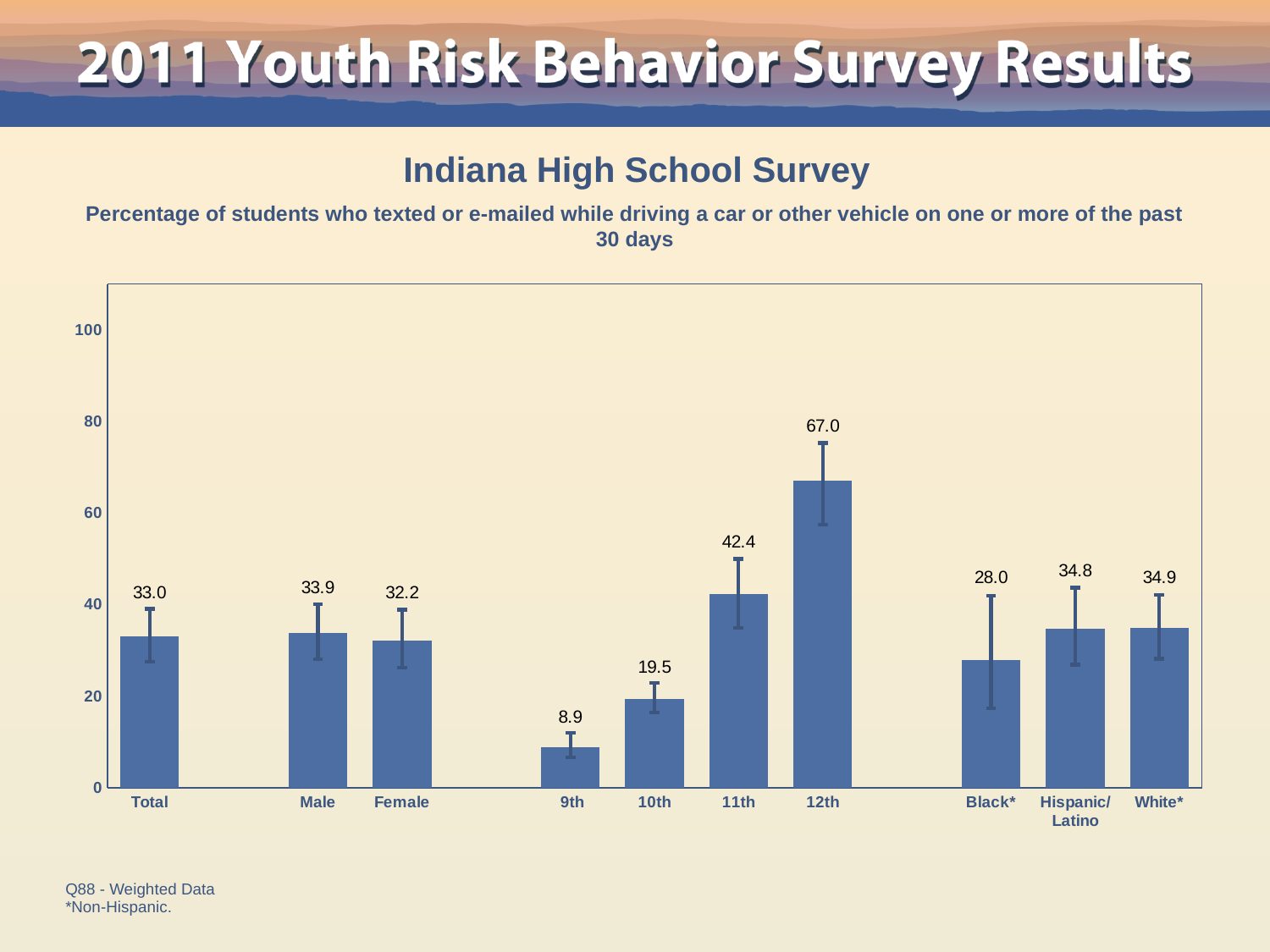
How many categories are shown on the x axis? 10 Do the values rise or fall from 9th grade to 12th grade? rise What is the difference between the values for 12th and 11th grade students? 24.6 What is the value for Female students? 32.2 What is the value for Hispanic/Latino students? 34.8 What kind of chart is shown on the slide? bar chart Which category has the lowest value? 9th Is the value for 10th grade students greater or less than 20? less What is the value for 12th grade students? 67.0 What is the difference between the values for Male and Female students? 1.7 Which is larger, the value for Black* or the value for White* students? White* Which category has the highest value? 12th